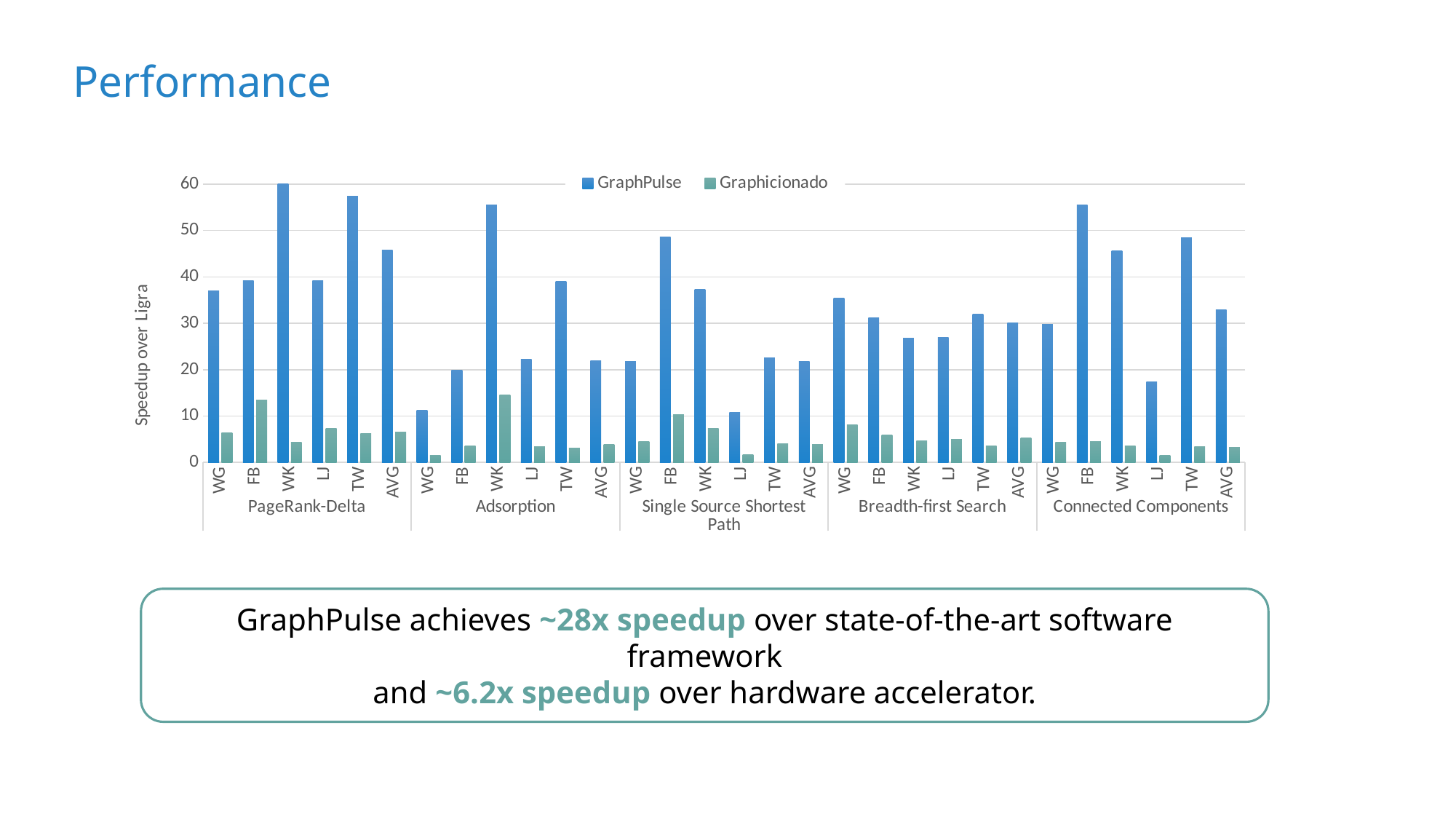
Which input has the highest GraphPulse speedup in the PageRank-Delta group? WK What kind of chart is shown on the slide? bar chart Which input has the highest GraphPulse speedup in the Connected Components group? FB What is the label of the vertical axis? Speedup over Ligra How many series does the legend list? 2 Which input has the lowest GraphPulse speedup in the Adsorption group? WG How many algorithm groups are shown along the x axis? 5 Is the GraphPulse value for WK in the PageRank-Delta group greater or less than 50? greater In the Adsorption group, which has the larger GraphPulse speedup, WK or TW? WK What are the two series named in the legend? GraphPulse and Graphicionado Which input has the lowest GraphPulse speedup in the Single Source Shortest Path group? LJ Is the GraphPulse value for LJ in the Single Source Shortest Path group greater or less than 20? less